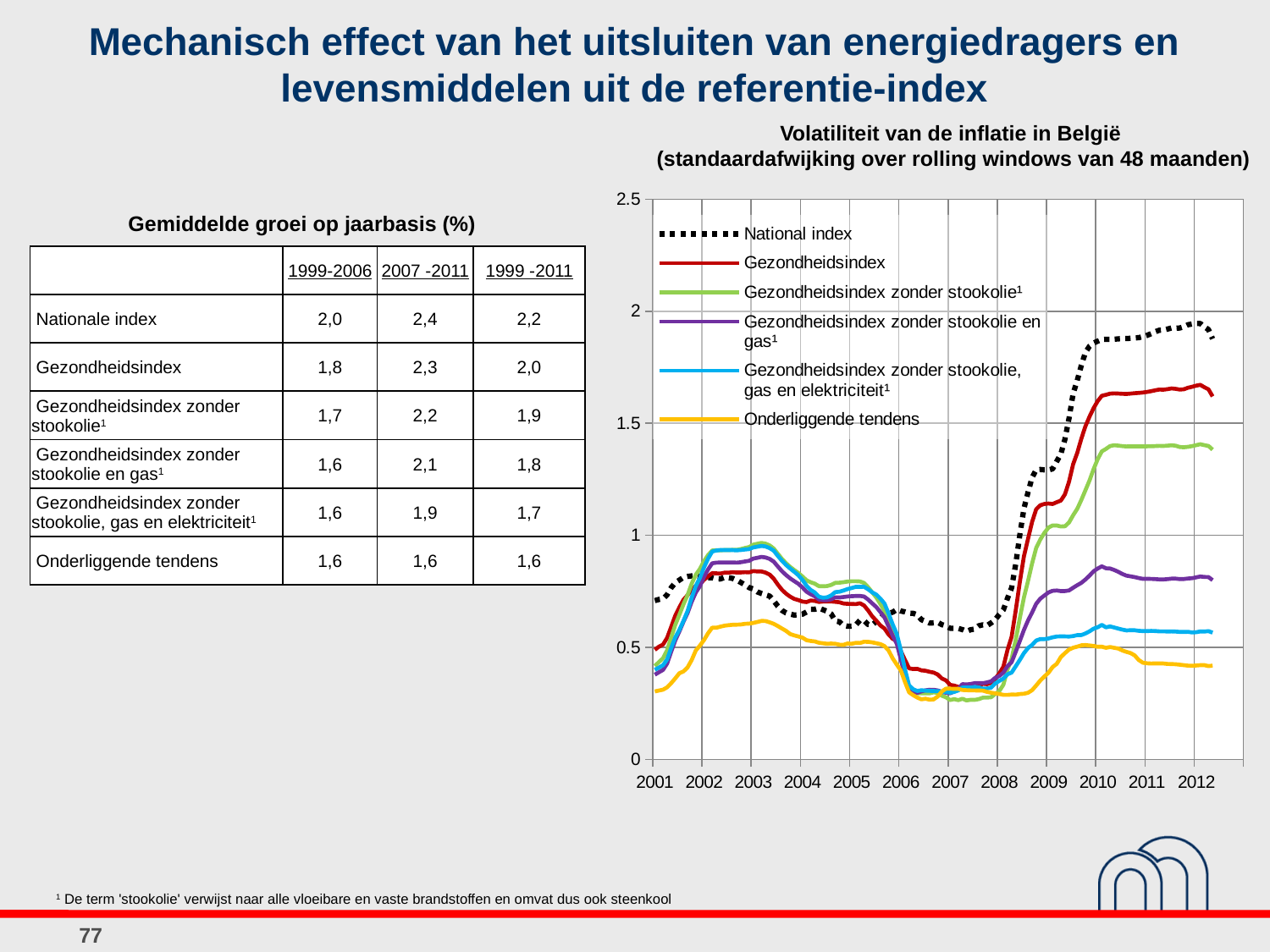
Does the National index rise or fall between 2008 and 2010? rise Is the value of Onderliggende tendens in 2012 greater or less than 0.5? less Which series has the lowest value at the end of the chart (2012)? Onderliggende tendens Which series in the chart is drawn as a dotted line? National index Is the value of the National index in 2012 greater or less than 2? less What kind of chart is shown on the slide? line chart Is the value of Gezondheidsindex zonder stookolie en gas in 2012 greater or less than 1? less How many series does the legend of the chart list? 6 Which series has the highest value at the end of the chart (2012)? National index What is the title of the chart? Volatiliteit van de inflatie in België (standaardafwijking over rolling windows van 48 maanden) In 2012, which is higher: Gezondheidsindex or Gezondheidsindex zonder stookolie? Gezondheidsindex